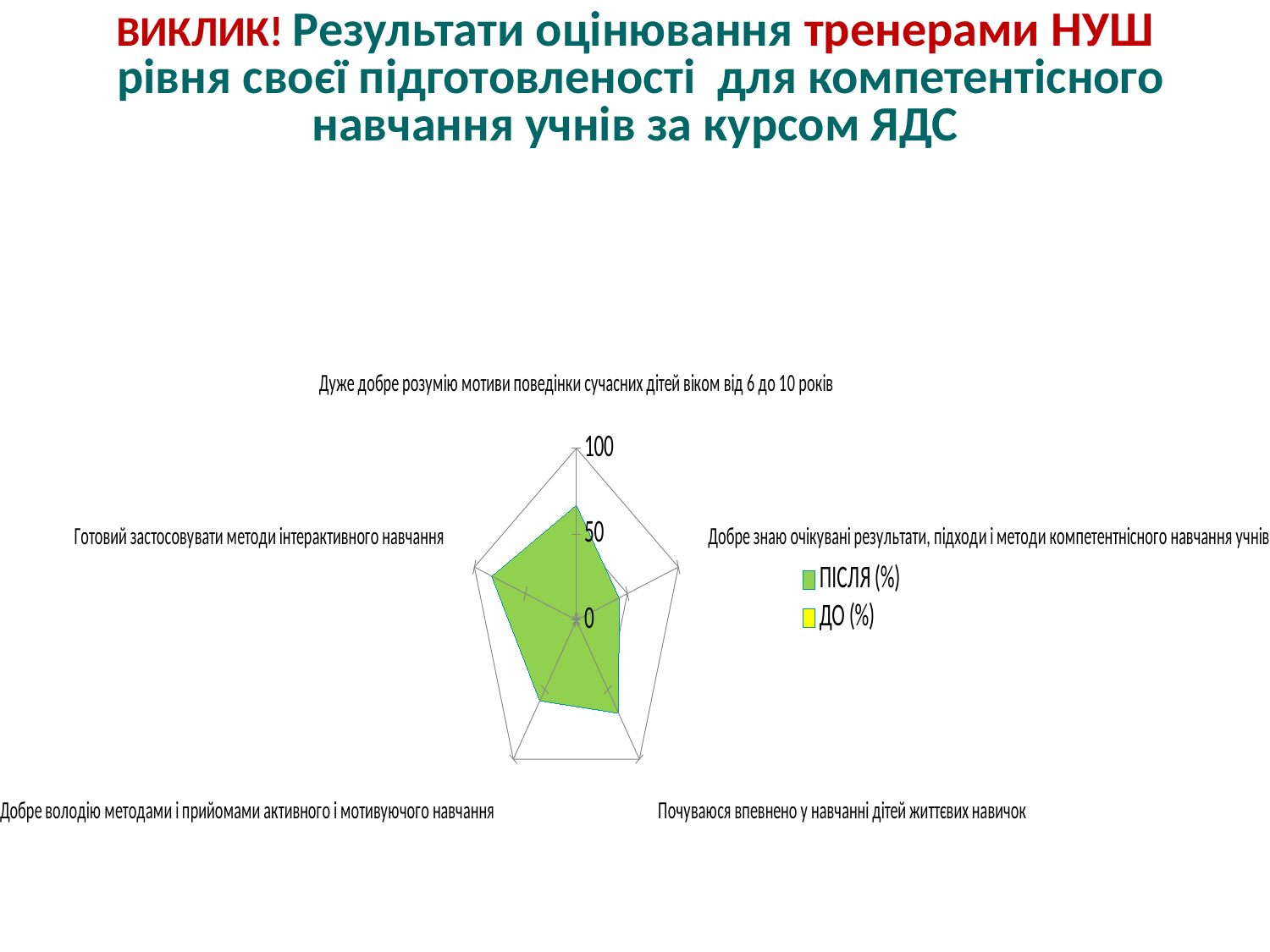
For the ПІСЛЯ (%) series, which category has the lowest value? Добре знаю очікувані результати, підходи і методи компетентнісного навчання учнів How many categories (axes) does the radar chart have? 5 What kind of chart is shown on the slide? Radar chart What are the two series named in the legend? ПІСЛЯ (%) and ДО (%) For the ПІСЛЯ (%) series, which is larger: 'Готовий застосовувати методи інтерактивного навчання' or 'Добре знаю очікувані результати, підходи і методи компетентнісного навчання учнів'? Готовий застосовувати методи інтерактивного навчання What colour represents the ПІСЛЯ (%) series? Green How many series does the legend list? 2 What is the maximum value shown on the radar chart's axis scale? 100 Is the ПІСЛЯ (%) value for 'Почуваюся впевнено у навчанні дітей життєвих навичок' greater or less than 50? greater Is the ПІСЛЯ (%) value for 'Готовий застосовувати методи інтерактивного навчання' greater or less than 50? greater Is the ПІСЛЯ (%) value for 'Дуже добре розумію мотиви поведінки сучасних дітей віком від 6 до 10 років' greater or less than 50? greater For the ПІСЛЯ (%) series, which category has the highest value? Готовий застосовувати методи інтерактивного навчання